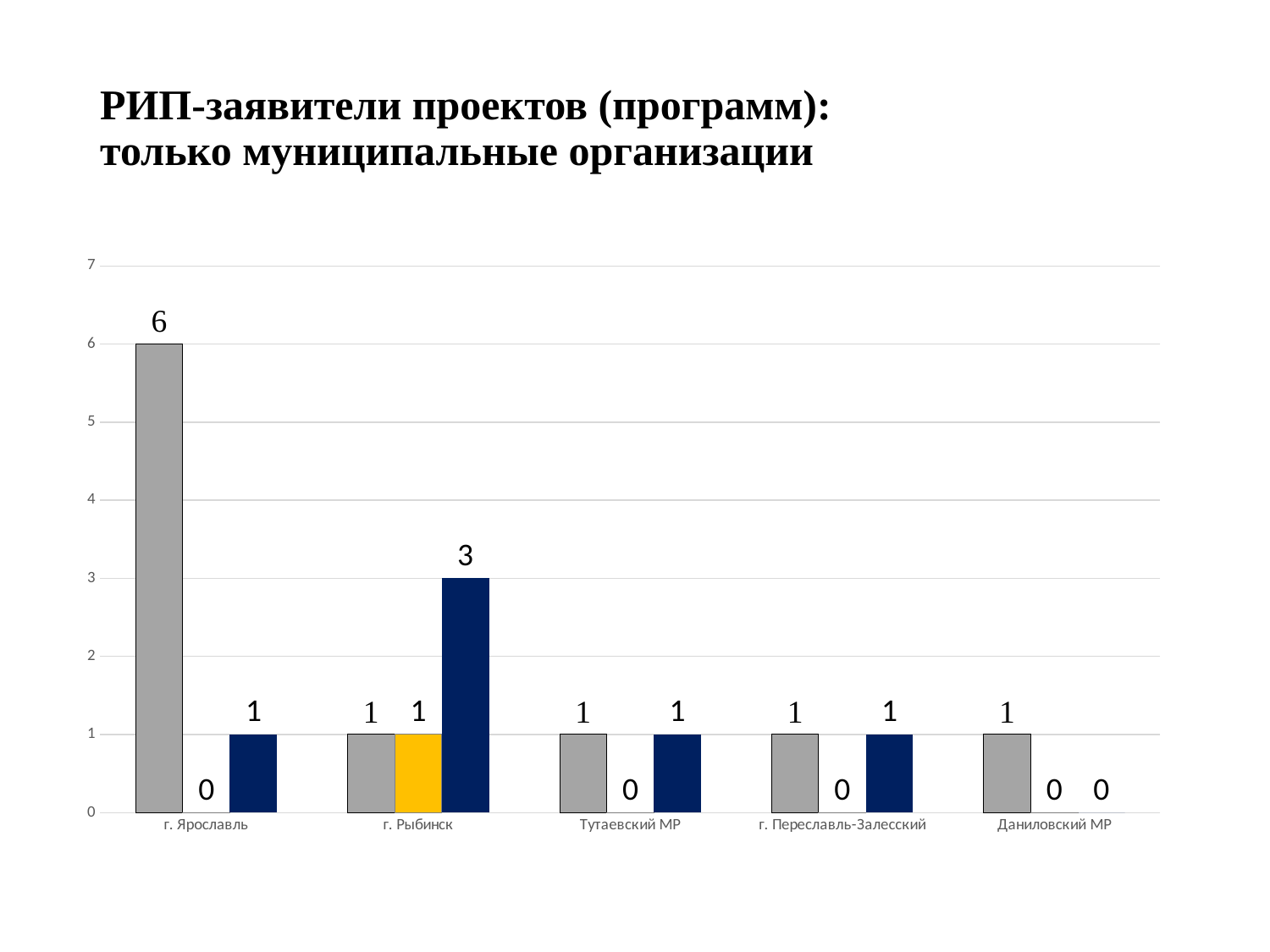
Which is larger: the grey bar for г. Ярославль or the dark blue bar for г. Ярославль? the grey bar for г. Ярославль What is the value of the dark blue bar for Даниловский МР? 0 Which category has the highest grey bar? г. Ярославль What is the value of the dark blue bar for г. Рыбинск? 3 What is the difference between the grey bar for г. Ярославль and the dark blue bar for г. Рыбинск? 3 How many categories are shown on the x axis? 5 What is the value of the grey bar for г. Ярославль? 6 What kind of chart is shown on the slide? bar chart Which category has the highest dark blue bar? г. Рыбинск What is the total of the three bars for г. Рыбинск? 5 What is the value of the yellow bar for г. Рыбинск? 1 What is the title of the slide? РИП-заявители проектов (программ): только муниципальные организации